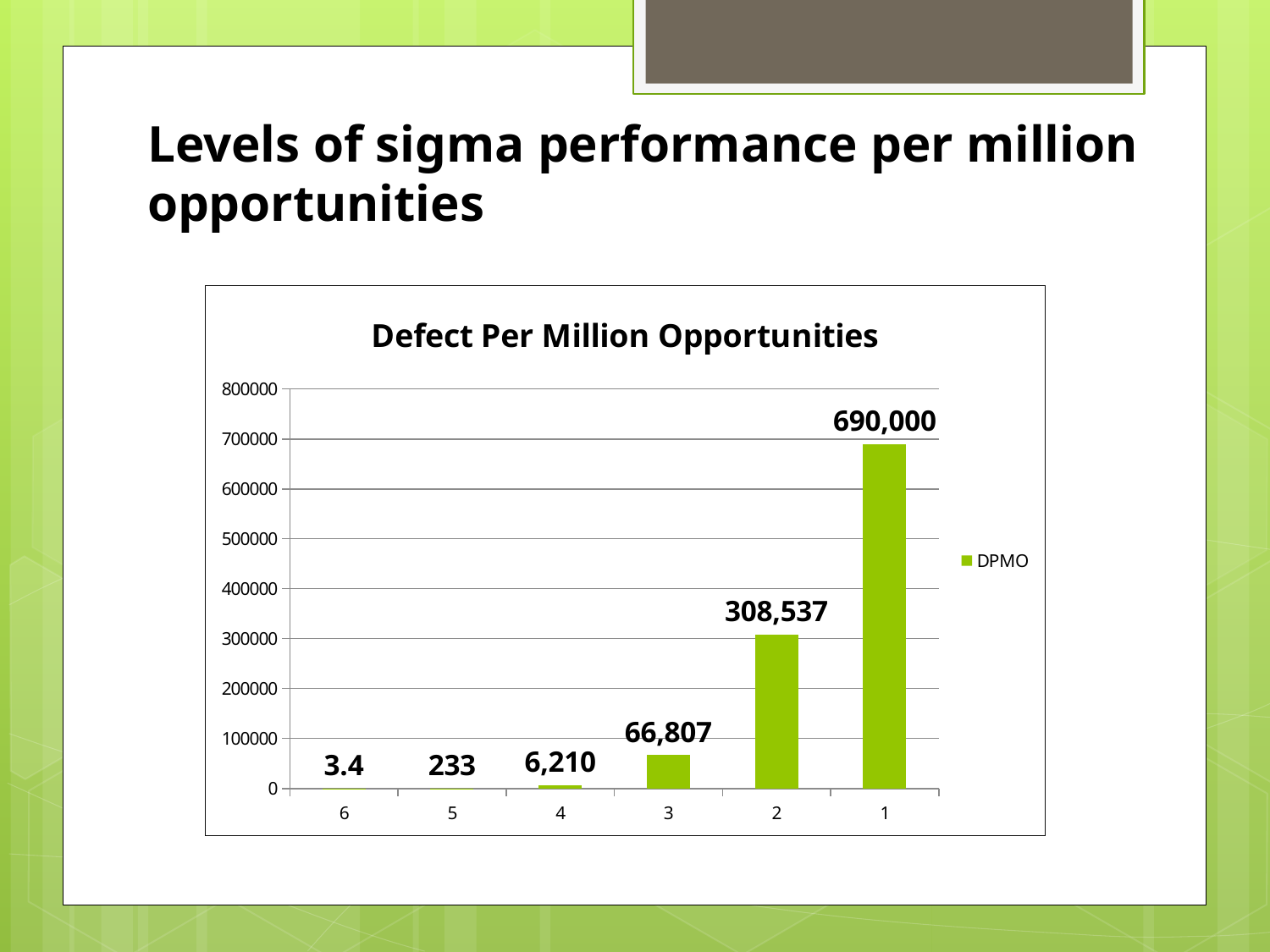
What is the title of the chart? Defect Per Million Opportunities How many sigma levels are shown on the x axis? 6 What is the DPMO value for sigma level 2? 308,537 Which has a larger DPMO value, sigma level 4 or sigma level 5? 4 What is the DPMO value for sigma level 3? 66,807 Is the DPMO value for sigma level 1 greater or less than 600000? greater Which sigma level has the highest DPMO value? 1 What is the difference between the DPMO values for sigma levels 1 and 2? 381,463 What kind of chart is shown? bar chart What is the DPMO value for sigma level 6? 3.4 Which sigma level has the lowest DPMO value? 6 How many series does the legend list? 1